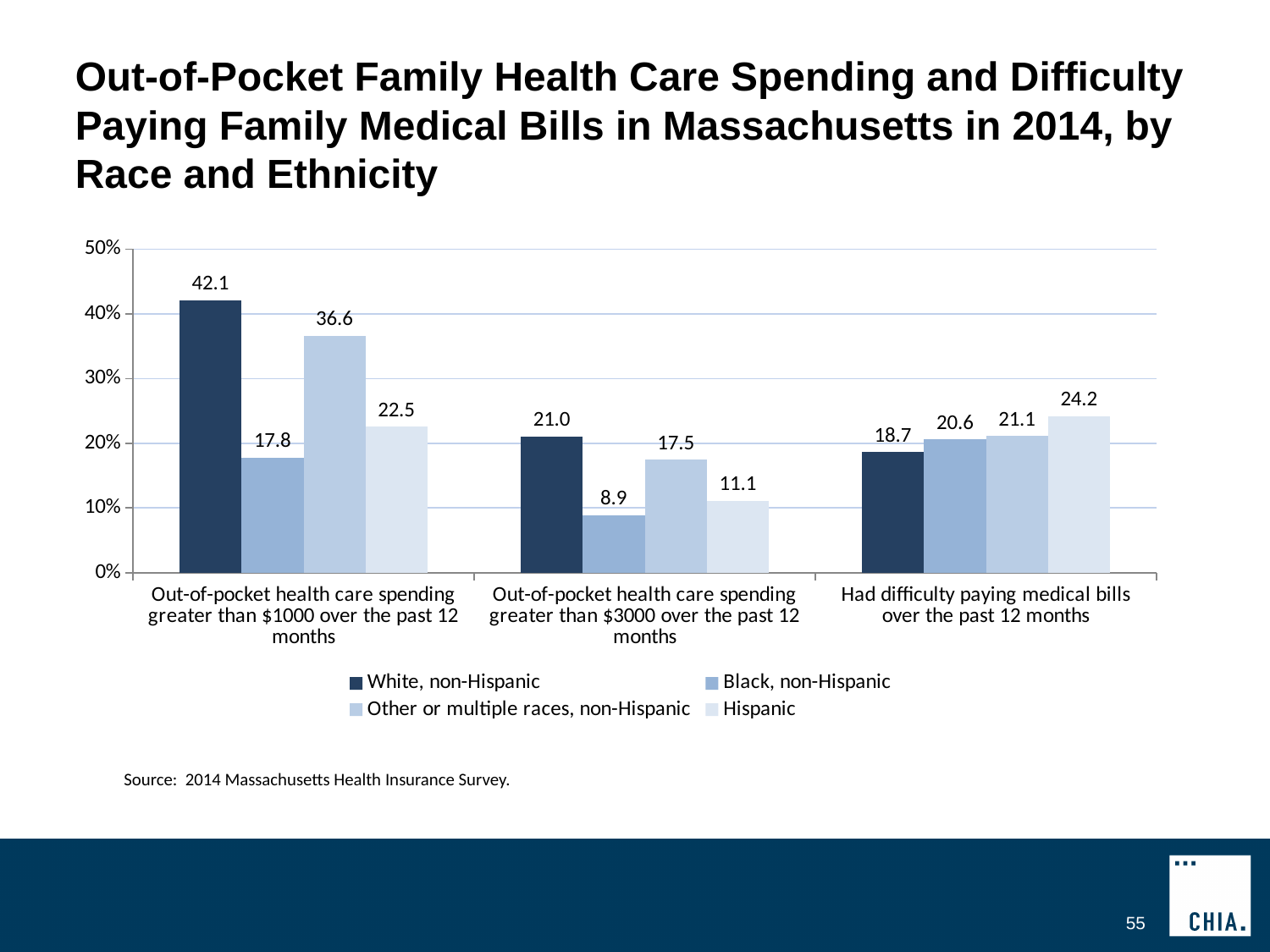
What is the value for White, non-Hispanic for out-of-pocket health care spending greater than $1000 over the past 12 months? 42.1 What is the value for Black, non-Hispanic for had difficulty paying medical bills over the past 12 months? 20.6 How many categories are shown on the x axis? 3 Which is larger for had difficulty paying medical bills over the past 12 months: the Hispanic value or the White, non-Hispanic value? Hispanic What is the value for Hispanic for out-of-pocket health care spending greater than $3000 over the past 12 months? 11.1 What is the difference between the White, non-Hispanic and Black, non-Hispanic values for out-of-pocket health care spending greater than $1000 over the past 12 months? 24.3 What is the source cited below the chart? 2014 Massachusetts Health Insurance Survey What is the difference between the Other or multiple races, non-Hispanic and Hispanic values for out-of-pocket health care spending greater than $3000 over the past 12 months? 6.4 What kind of chart is shown on the slide? Bar chart How many series does the legend list? 4 Which group has the highest value for out-of-pocket health care spending greater than $1000 over the past 12 months? White, non-Hispanic Which group has the lowest value for out-of-pocket health care spending greater than $3000 over the past 12 months? Black, non-Hispanic